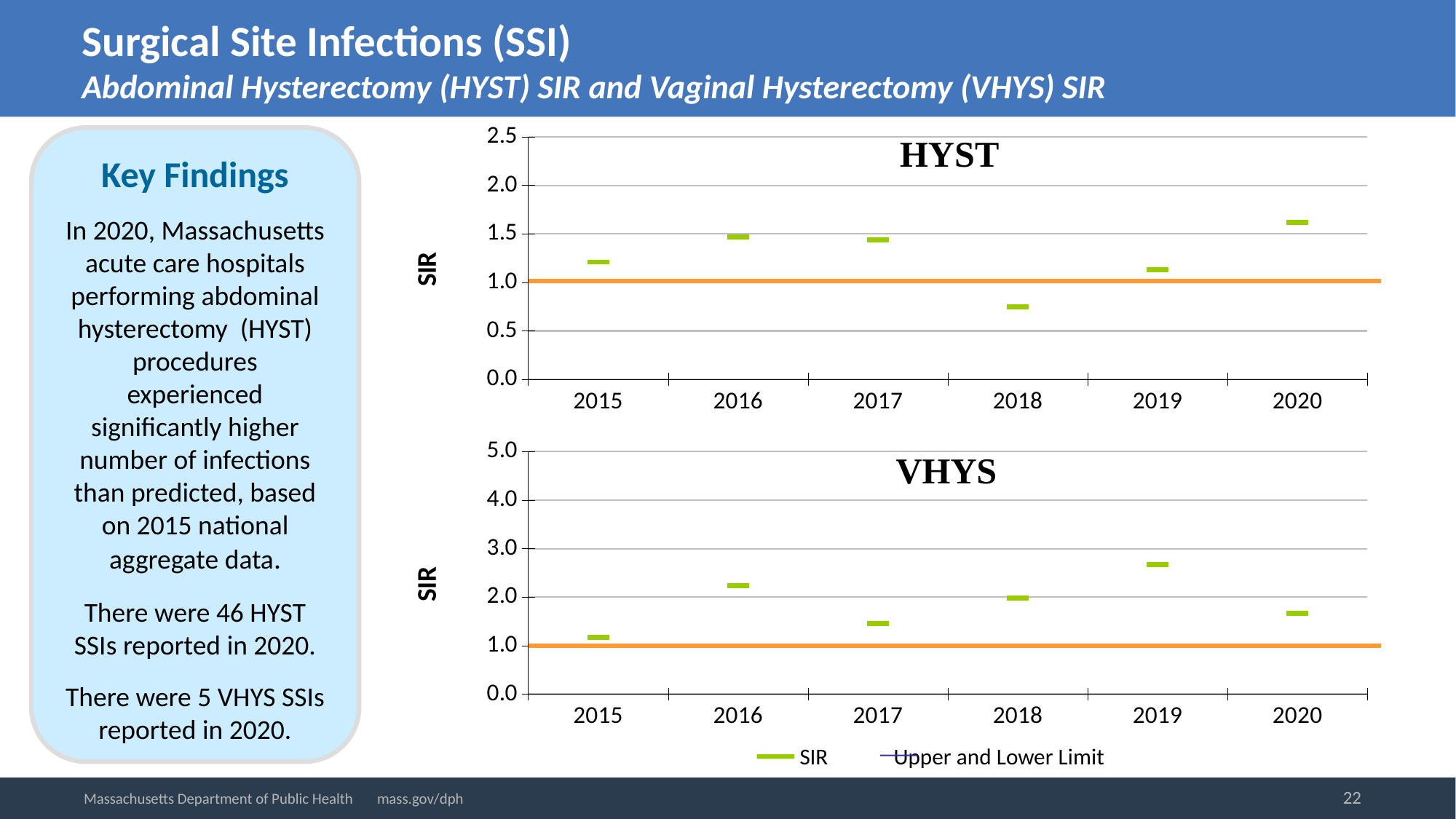
In the HYST chart, is the SIR value for 2018 greater or less than 1.0? less In the VHYS chart, which year has the highest SIR? 2019 In the VHYS chart, is the SIR value for 2019 greater or less than 2.0? greater How many years are plotted on the x axis of the VHYS chart? 6 How many entries does the legend below the VHYS chart list? 2 In the VHYS chart, which year has the lowest SIR? 2015 In the VHYS chart, which year has the larger SIR, 2018 or 2020? 2018 In the HYST chart, which year has the larger SIR, 2015 or 2016? 2016 In the HYST chart, is the SIR value for 2020 greater or less than 1.5? greater In the HYST chart, which year has the highest SIR? 2020 In the HYST chart, which year has the lowest SIR? 2018